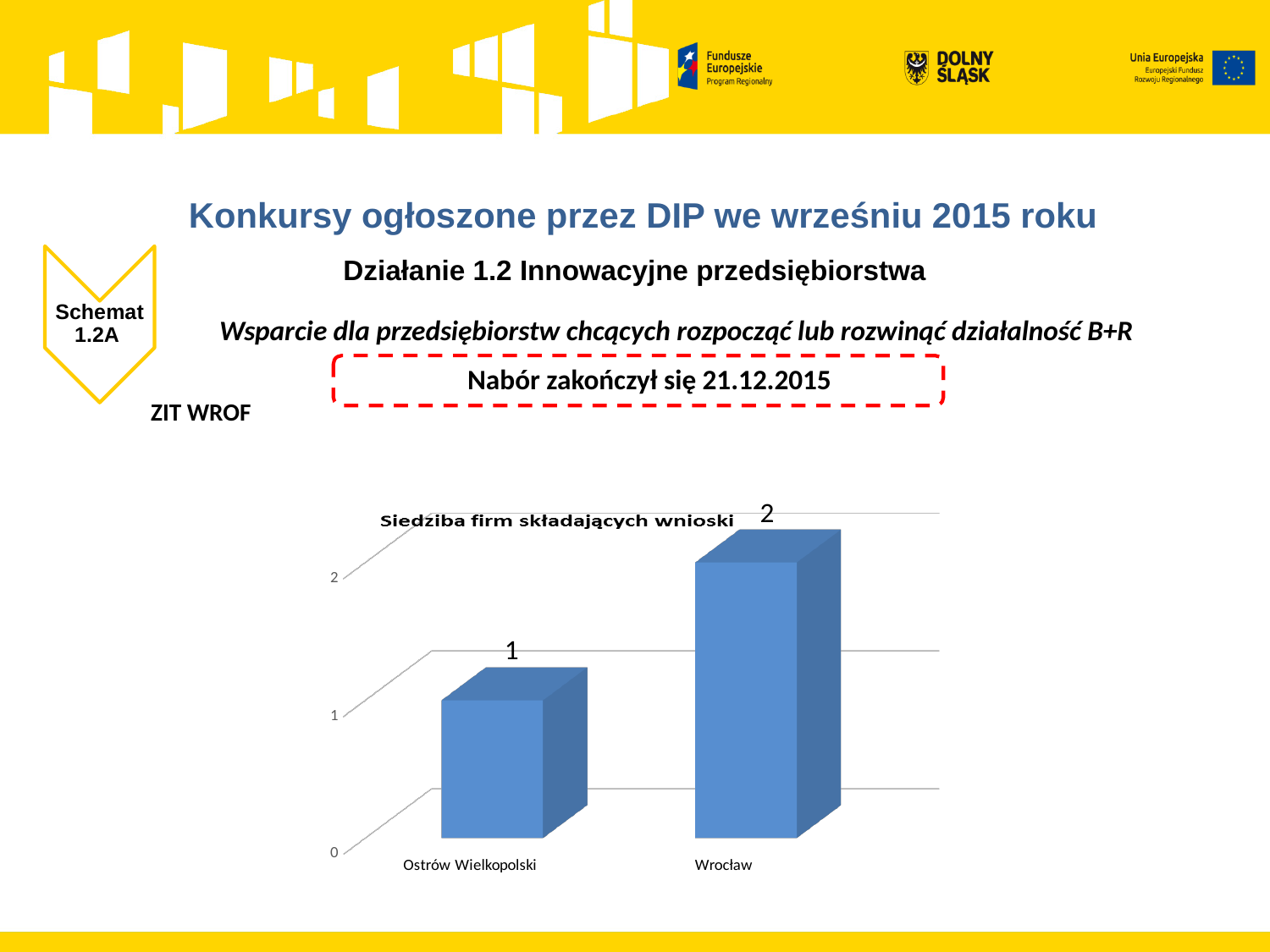
What is the total of the values for Ostrów Wielkopolski and Wrocław? 3 What is the difference between the values for Wrocław and Ostrów Wielkopolski? 1 Which category has the lowest value? Ostrów Wielkopolski Which category has the highest value? Wrocław Which is larger, the value for Wrocław or the value for Ostrów Wielkopolski? Wrocław What is the value for Wrocław? 2 What is the value for Ostrów Wielkopolski? 1 What is the title of the chart? Siedziba firm składających wnioski Do the values rise or fall from Ostrów Wielkopolski to Wrocław? rise What kind of chart is shown on the slide? bar chart What is the highest tick value shown on the vertical axis of the chart? 2 How many categories are shown on the x axis of the chart? 2